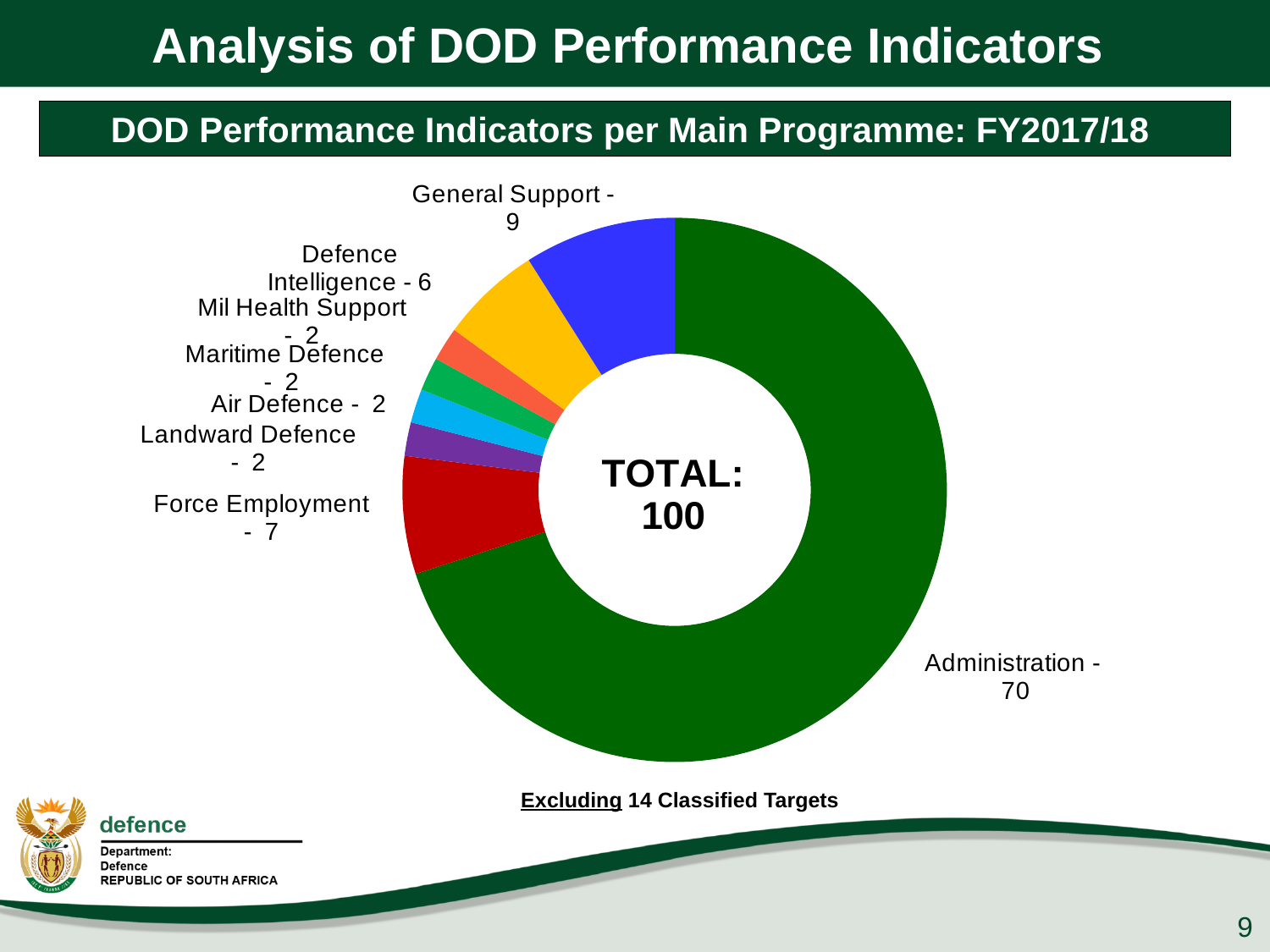
How many performance indicators does Force Employment have? 7 What is the difference between the number of indicators for Administration and General Support? 61 How many performance indicators does the Administration programme have? 70 Which has more performance indicators, Force Employment or Defence Intelligence? Force Employment What total is shown in the centre of the chart? 100 How many performance indicators does Defence Intelligence have? 6 What kind of chart is shown on the slide? Pie chart (doughnut) How many performance indicators does General Support have? 9 What share of the total performance indicators does Administration account for? 70% What is the title of the chart? DOD Performance Indicators per Main Programme: FY2017/18 How many main programmes are shown in the chart? 8 Which main programme has the most performance indicators? Administration